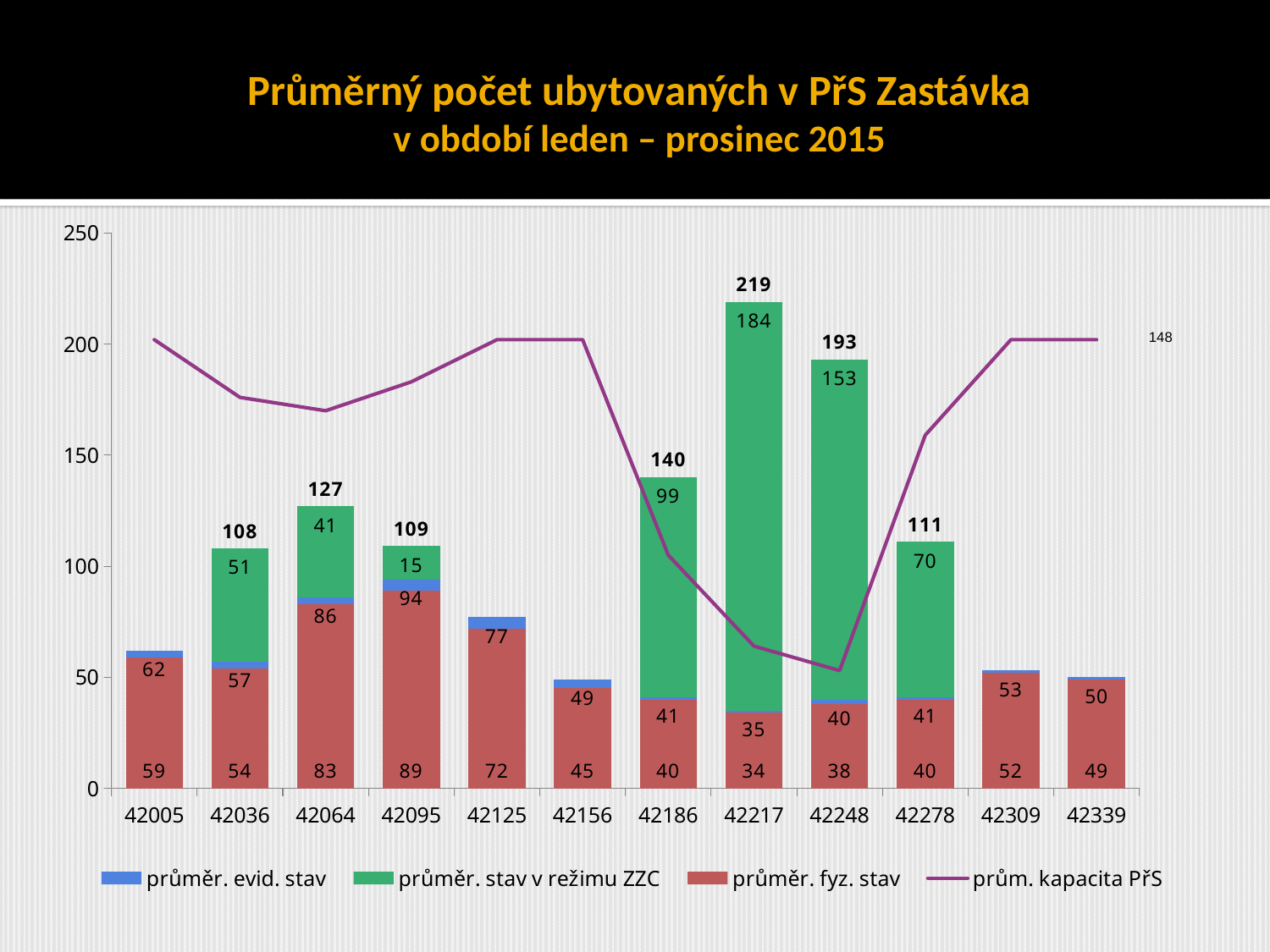
What is the value of průměr. fyz. stav for category 42095? 89 Is the value of prům. kapacita PřS at category 42248 greater or less than 100? less What is the difference between the stacked bar totals for 42217 and 42248? 26 Which category has the lowest value of průměr. fyz. stav? 42217 What is the value of průměr. stav v režimu ZZC for category 42217? 184 Which is larger, průměr. fyz. stav for 42064 or for 42095? 42095 What kind of chart is shown on the slide? bar chart (with a line series) How many categories are shown on the x axis? 12 How many series does the legend list? 4 What is the value of průměr. evid. stav for category 42125? 77 Which category has the highest stacked bar total? 42217 What is the total labelled above the stacked bar for category 42186? 140